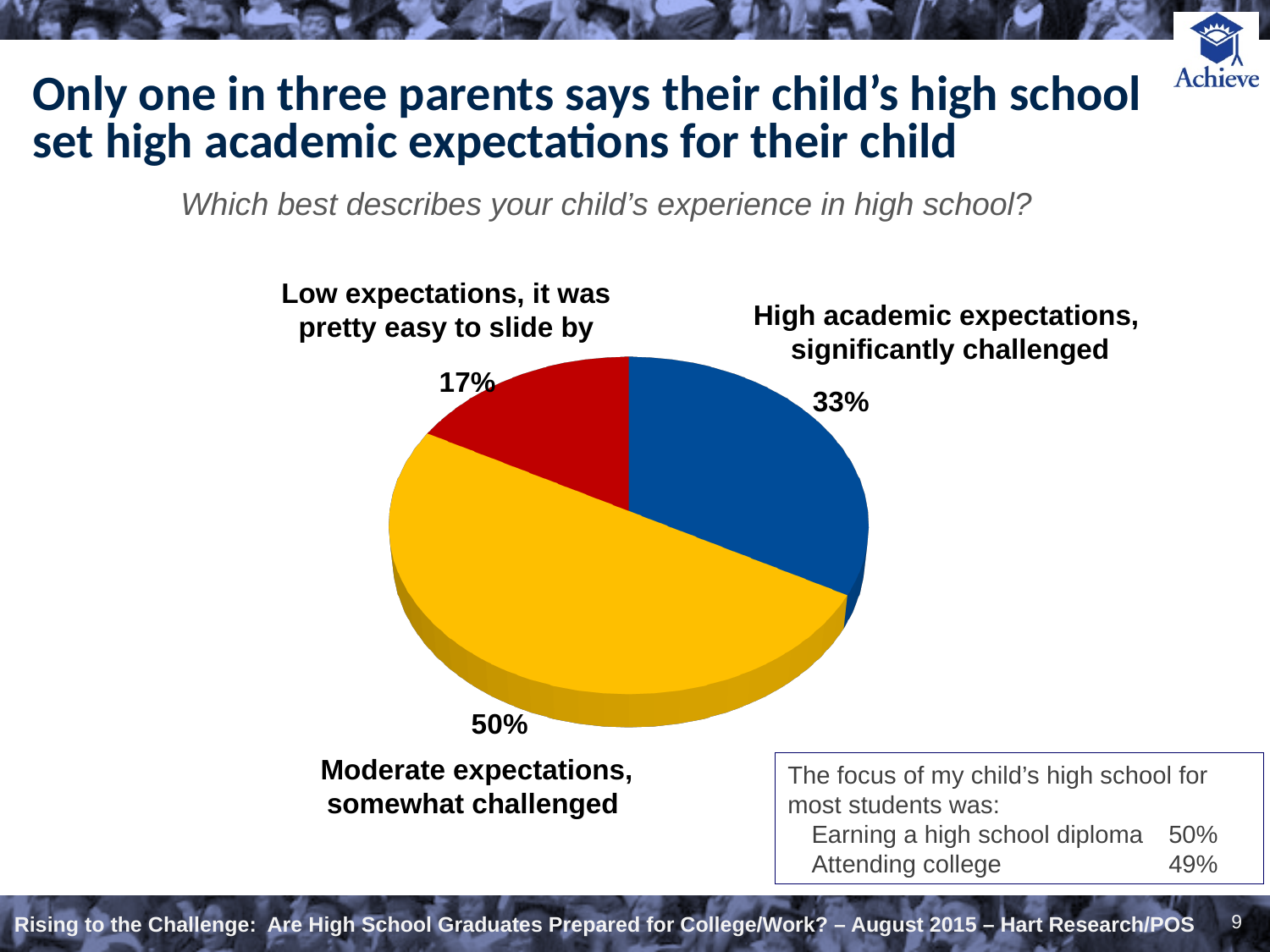
What percentage of parents said their child's high school had low expectations, it was pretty easy to slide by? 17% How many slices does the pie chart have? 3 What colour is the slice for moderate expectations, somewhat challenged? Yellow What kind of chart is shown on the slide? Pie chart Which is larger: the share for high academic expectations or the share for low expectations? High academic expectations, significantly challenged What is the difference in percentage points between the moderate expectations slice and the high academic expectations slice? 17 What is the difference in percentage points between the high academic expectations slice and the low expectations slice? 16 What percentage of parents said their child's high school had moderate expectations, somewhat challenged? 50% What percentage of parents said their child's high school had high academic expectations, significantly challenged? 33% Which category has the smallest share of the pie? Low expectations, it was pretty easy to slide by What survey question is shown above the pie chart? Which best describes your child's experience in high school? Which category has the largest share of the pie? Moderate expectations, somewhat challenged